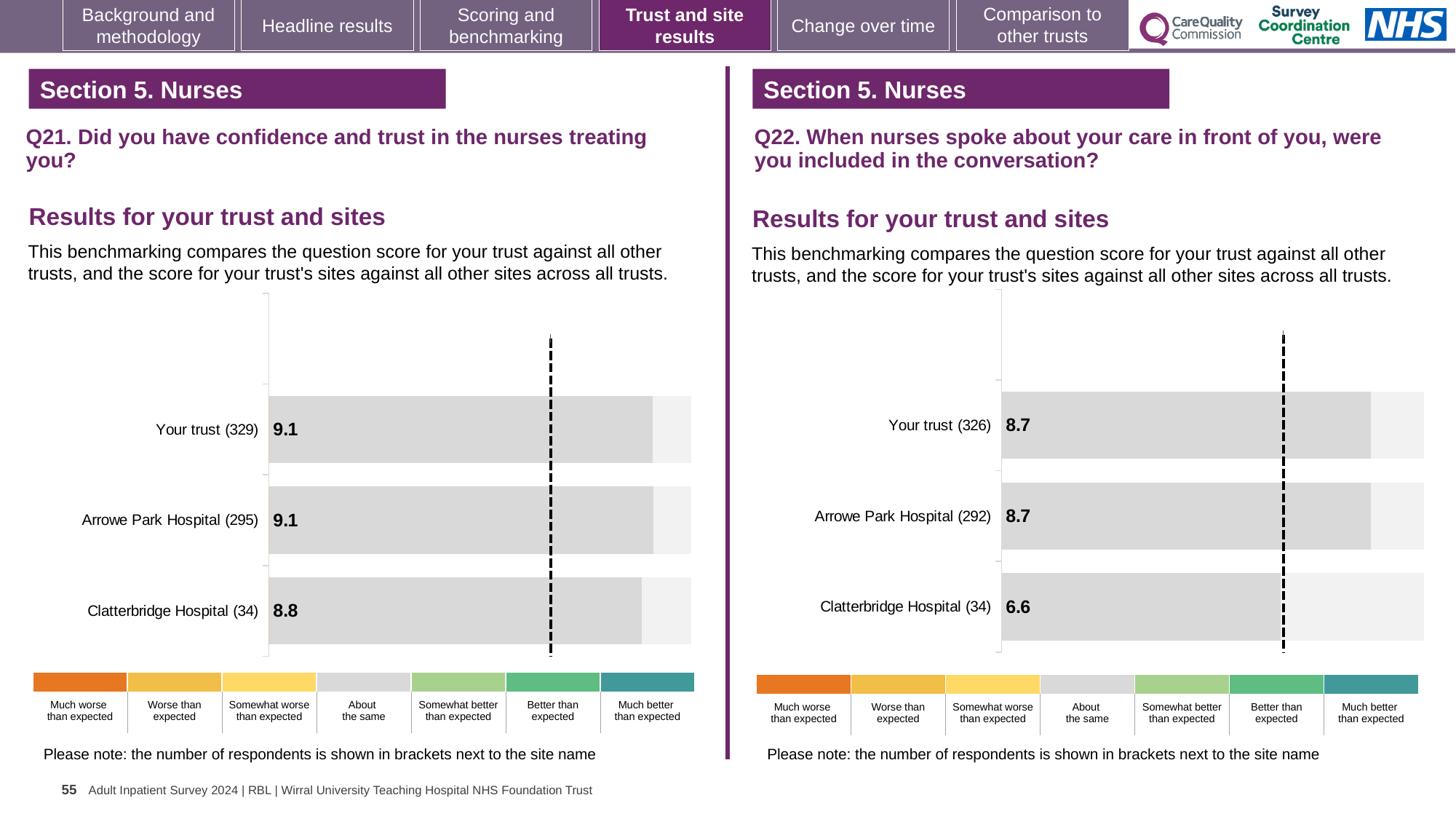
How many benchmark categories are shown in the colour key below the Q21 chart on the left? 7 In the Q22 chart on the right, which has the larger score, Arrowe Park Hospital (292) or Clatterbridge Hospital (34)? Arrowe Park Hospital (292) In the Q22 chart on the right, what is the score for Clatterbridge Hospital (34)? 6.6 In the Q21 chart on the left, which site or trust has the lowest score? Clatterbridge Hospital (34) In the Q22 chart on the right, which site or trust has the lowest score? Clatterbridge Hospital (34) In the Q21 chart on the left, what is the score for Clatterbridge Hospital (34)? 8.8 In the Q22 chart on the right, what is the difference between the scores for Your trust (326) and Clatterbridge Hospital (34)? 2.1 In the Q22 chart on the right, what is the score for Arrowe Park Hospital (292)? 8.7 In the Q21 chart on the left, what is the difference between the scores for Arrowe Park Hospital (295) and Clatterbridge Hospital (34)? 0.3 In the Q21 chart on the left, what is the score for Your trust (329)? 9.1 What kind of chart is used for the Q22 results on the right? Bar chart How many bars are plotted in the Q21 chart on the left? 3